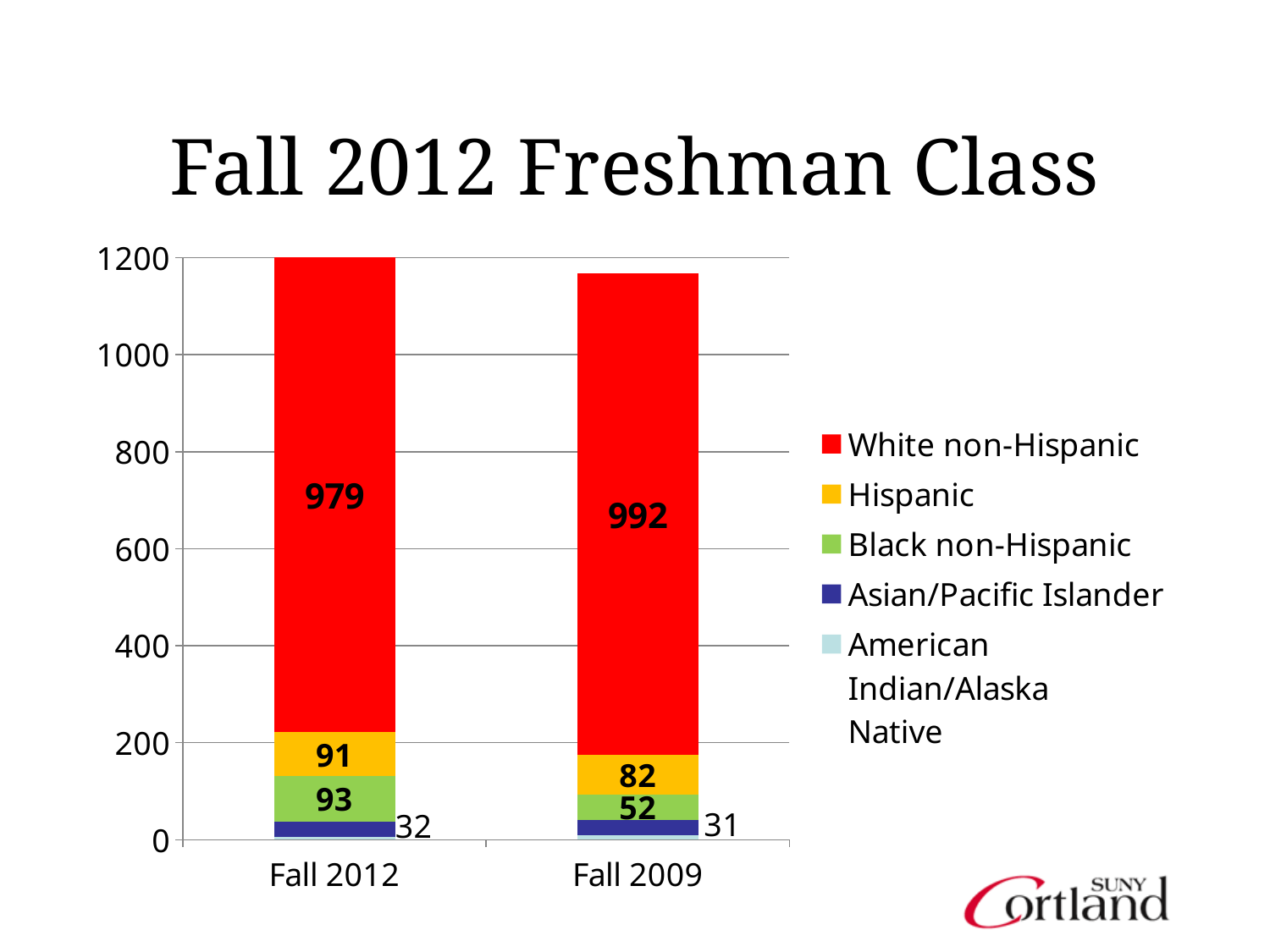
Is the total height of the Fall 2012 stacked bar greater or less than 1000? greater How many series does the legend list? 5 How many categories are shown on the x axis? 2 What is the value for Black non-Hispanic in Fall 2012? 93 What kind of chart is shown on the slide? stacked bar chart Which year has the larger Hispanic value, Fall 2012 or Fall 2009? Fall 2012 Which year has the larger White non-Hispanic value, Fall 2012 or Fall 2009? Fall 2009 What is the value for Hispanic in Fall 2009? 82 What is the value for Asian/Pacific Islander in Fall 2009? 31 What is the difference between the White non-Hispanic values for Fall 2009 and Fall 2012? 13 What is the value for White non-Hispanic in Fall 2012? 979 What is the difference between the Black non-Hispanic values for Fall 2012 and Fall 2009? 41